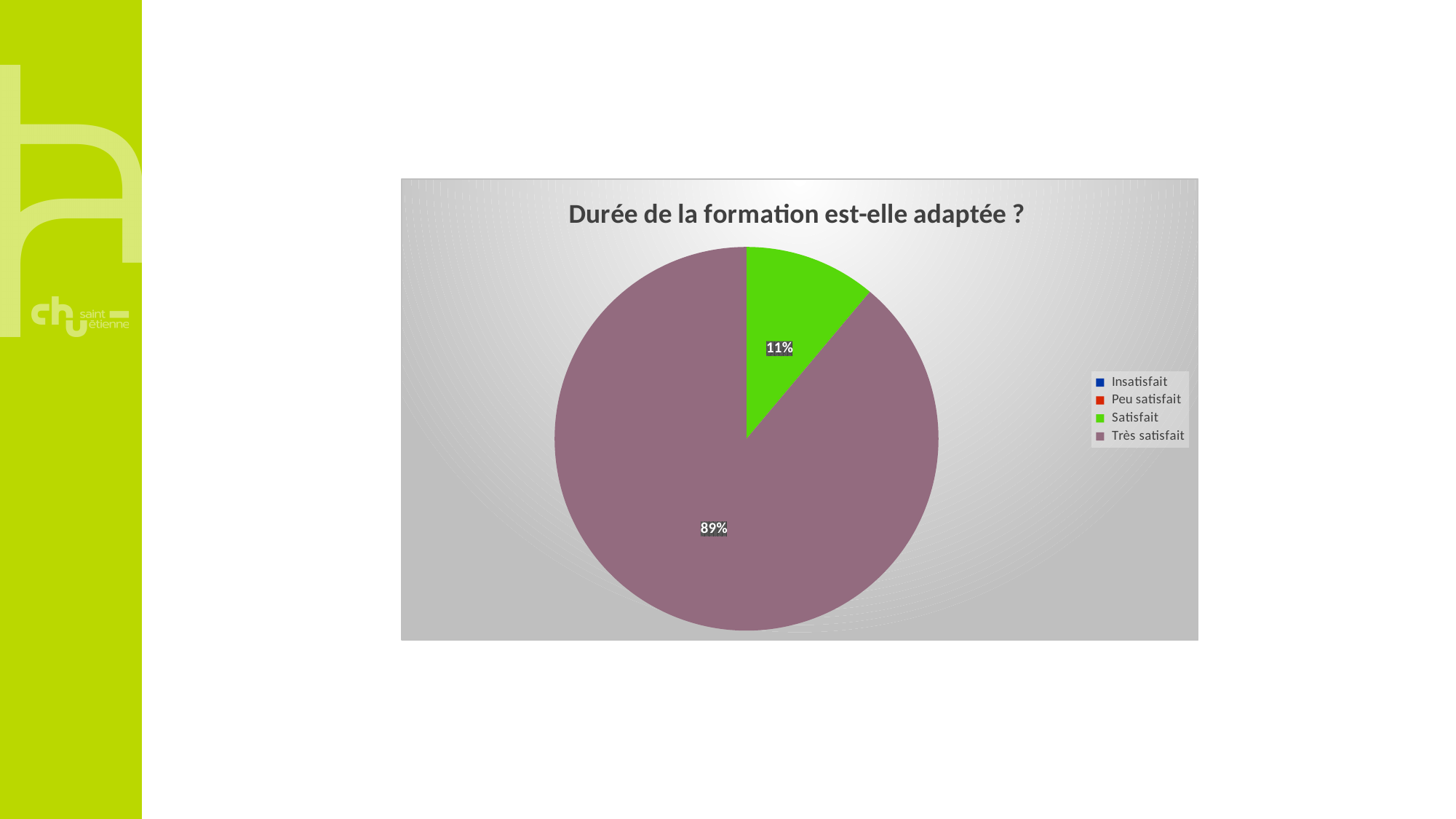
What kind of chart is shown on the slide? pie chart How many slices are visible in the pie? 2 Which is larger, the share for "Satisfait" or the share for "Très satisfait"? Très satisfait What is the difference in percentage points between "Très satisfait" and "Satisfait"? 78 How many entries does the legend list? 4 Which category has the largest slice of the pie? Très satisfait What is the title of the chart? Durée de la formation est-elle adaptée ? What colour is the "Satisfait" slice? green What share of the pie does "Satisfait" represent? 11% What share of the pie does "Très satisfait" represent? 89%